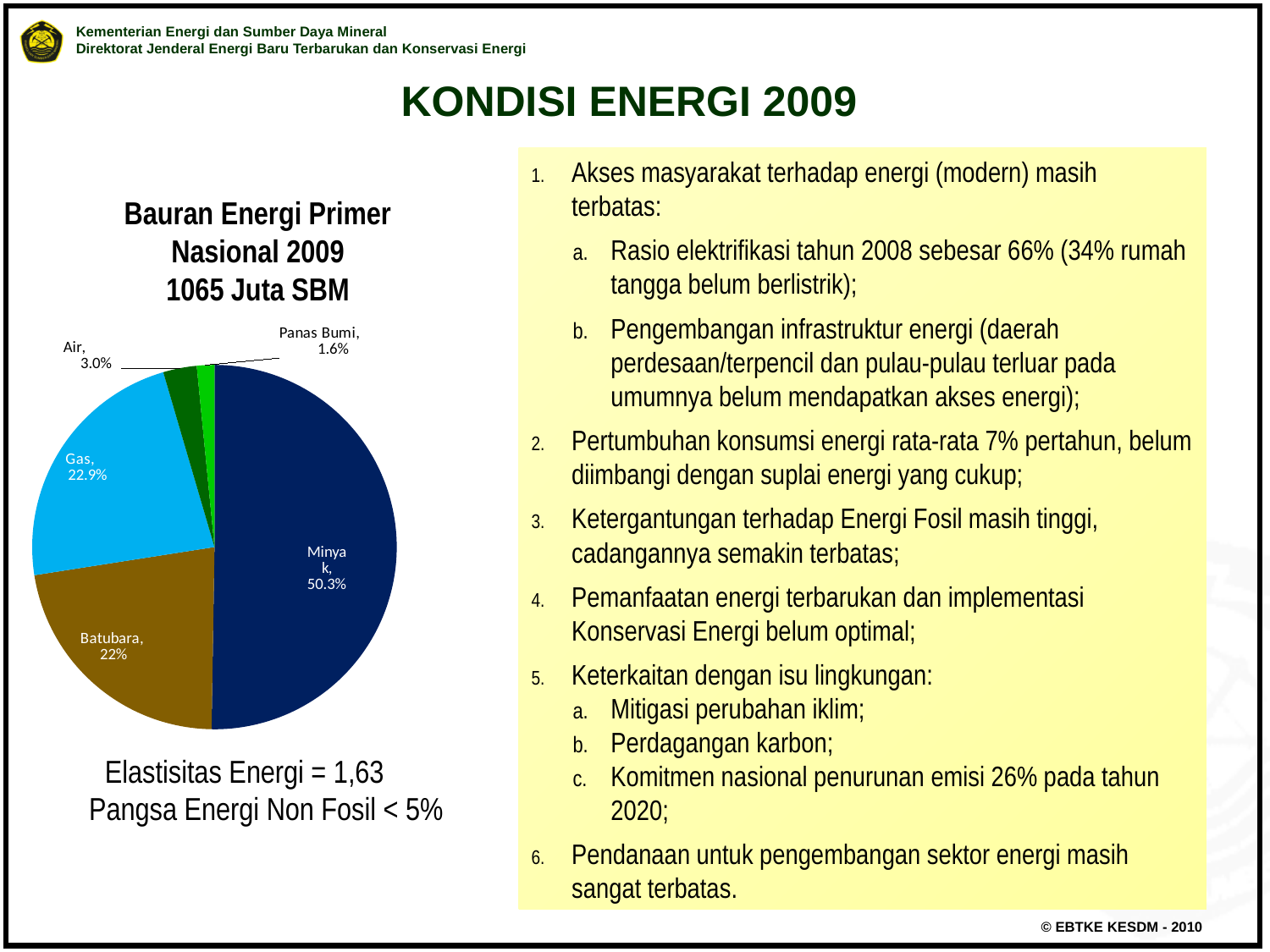
What kind of chart is shown on the slide? pie chart Which is larger, the Air slice or the Panas Bumi slice? Air Which slice of the pie is the largest? Minyak How many slices does the pie chart have? 5 What share of the pie does Batubara have? 22% What share of the pie does Panas Bumi have? 1.6% What share of the pie does Minyak have? 50.3% Which slice of the pie is the smallest? Panas Bumi What is the title of the chart on the slide? Bauran Energi Primer Nasional 2009 1065 Juta SBM What share of the pie does Gas have? 22.9% What is the difference in percentage points between the Minyak and Gas slices? 27.4 What share of the pie does Air have? 3.0%